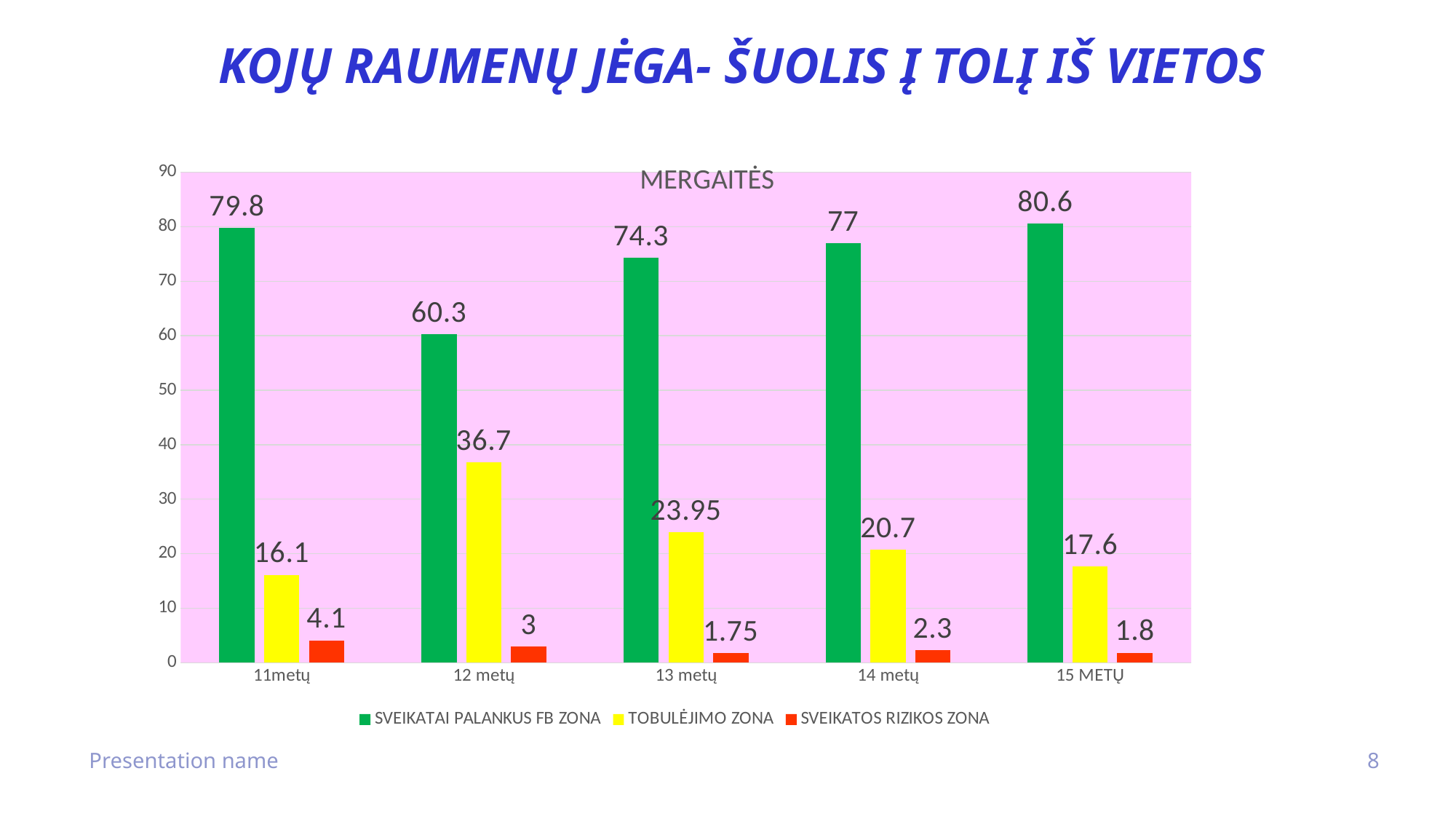
What is the value of SVEIKATAI PALANKUS FB ZONA for 11metų? 79.8 Which colour represents SVEIKATOS RIZIKOS ZONA in the legend? Red Which age group has the lowest SVEIKATAI PALANKUS FB ZONA value? 12 metų How many series does the legend list? 3 What is the value of SVEIKATOS RIZIKOS ZONA for 13 metų? 1.75 Which is larger, the TOBULĖJIMO ZONA value for 13 metų or for 14 metų? 13 metų What is the difference between the SVEIKATAI PALANKUS FB ZONA values for 15 METŲ and 12 metų? 20.3 Which age group has the highest SVEIKATAI PALANKUS FB ZONA value? 15 METŲ What is the value of TOBULĖJIMO ZONA for 12 metų? 36.7 What kind of chart is shown on the slide? Bar chart What is the title shown inside the chart area? MERGAITĖS How many age groups are shown on the x axis? 5